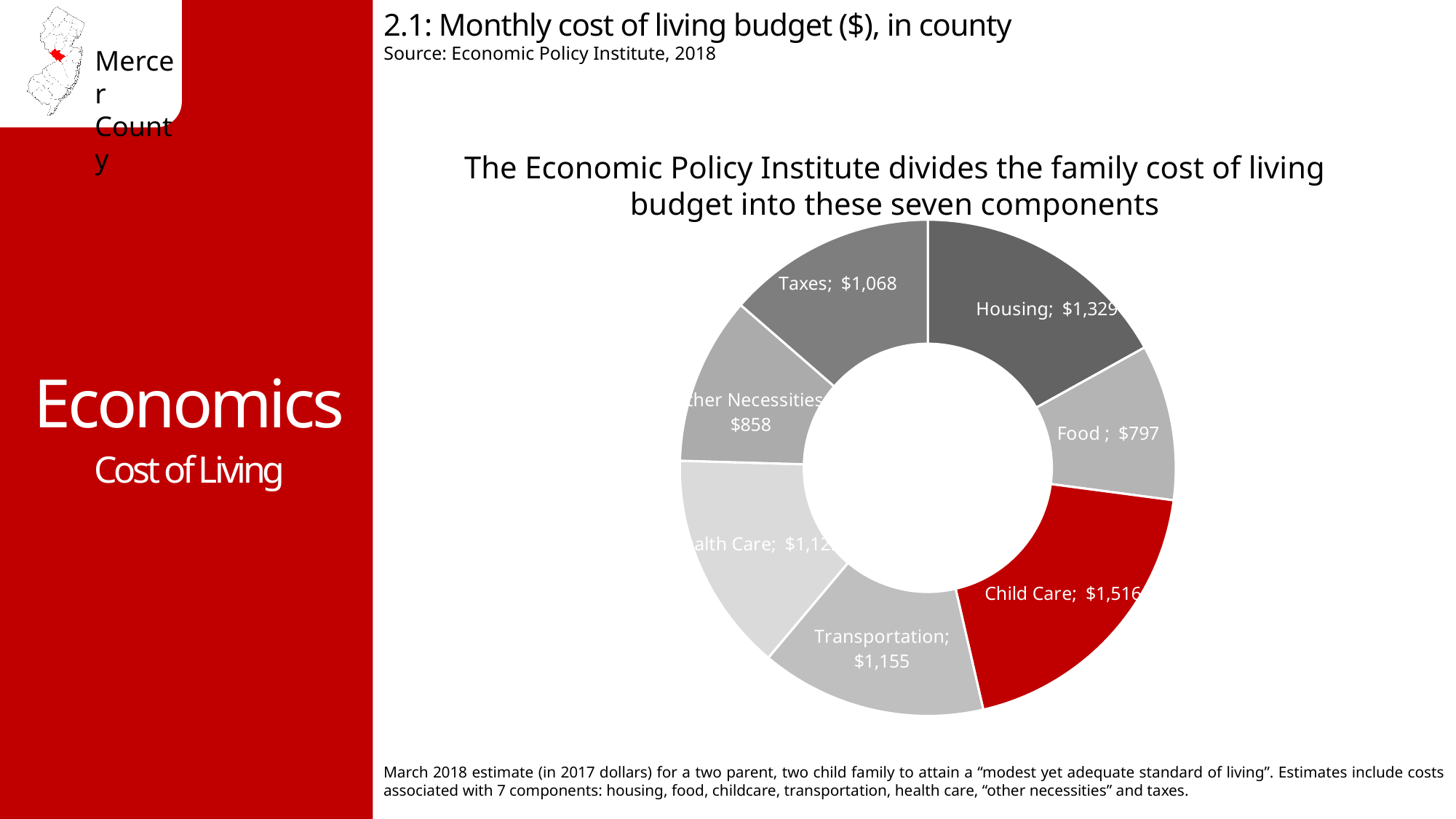
How many components are shown in the chart? 7 How much more is the monthly cost of Child Care than Housing? $187 Which is larger, the monthly cost for Taxes or for Transportation? Transportation Which component has the highest monthly cost? Child Care Which component has the lowest monthly cost? Food What is the monthly cost for Food shown on the chart? $797 What is the monthly cost for Taxes shown on the chart? $1,068 What is the monthly cost for Transportation shown on the chart? $1,155 What is the monthly cost for Child Care shown on the chart? $1,516 What is the monthly cost for Housing shown on the chart? $1,329 What is the monthly cost for Other Necessities shown on the chart? $858 What type of chart is used on this slide? Doughnut (pie) chart